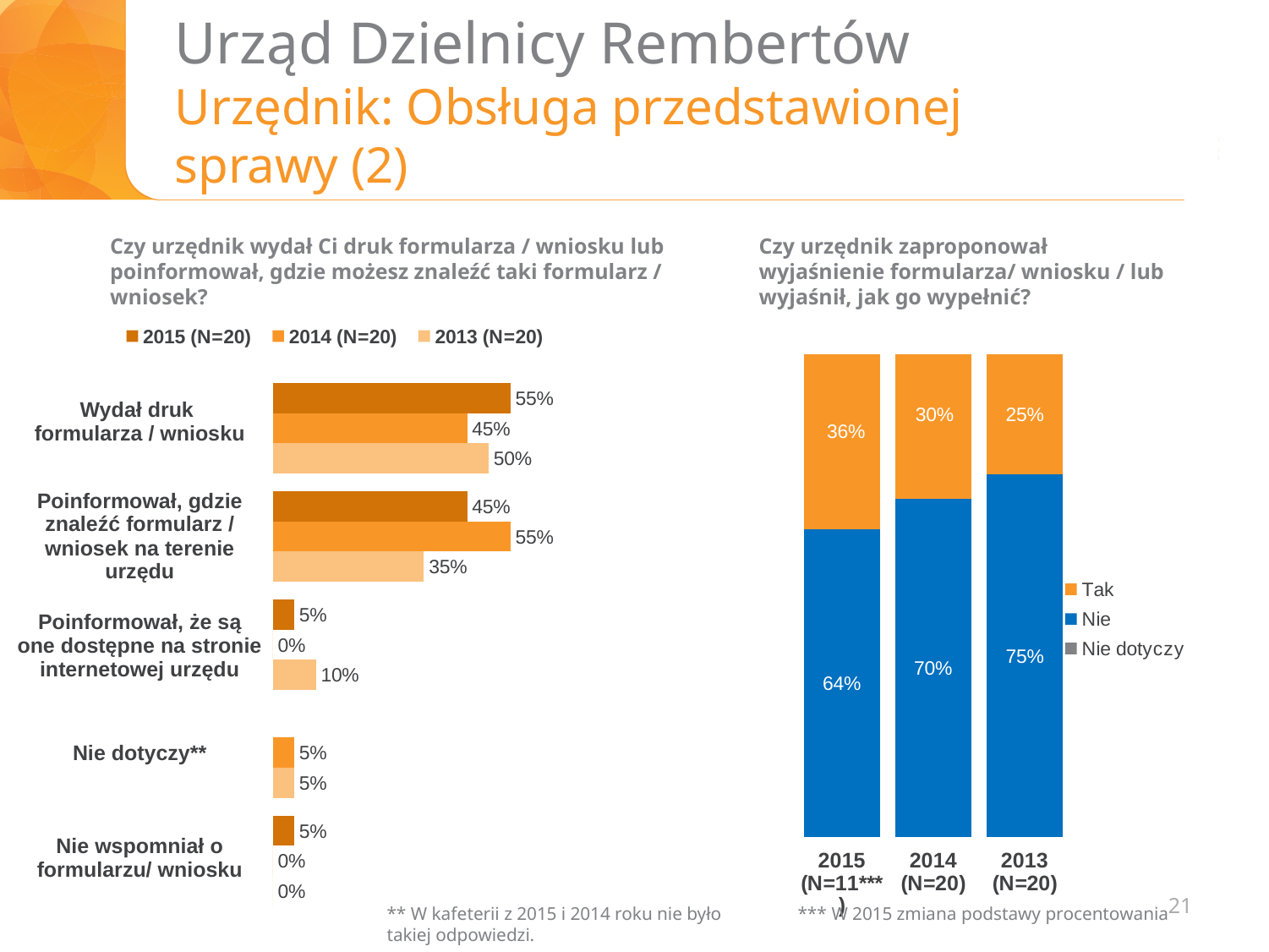
In the right chart, what is the "Tak" share for 2015? 36% What type of chart is the left chart? Bar chart In the right chart, is the "Tak" share for 2014 larger or smaller than for 2013? Larger In the left chart, which year has the highest value for "Poinformował, gdzie znaleźć formularz / wniosek na terenie urzędu"? 2014 (N=20) In the left chart, what is the 2013 value for "Poinformował, gdzie znaleźć formularz / wniosek na terenie urzędu"? 35% In the right chart, which year has the highest "Nie" share? 2013 (N=20) In the left chart, how many series does the legend list? 3 In the left chart, what is the difference between the 2015 and 2014 values for "Wydał druk formularza / wniosku"? 10% In the right chart, what is the "Nie" share for 2013? 75% In the left chart, what is the 2015 value for "Wydał druk formularza / wniosku"? 55% In the right chart, how many entries does the legend list? 3 In the left chart, what is the 2013 value for "Poinformował, że są one dostępne na stronie internetowej urzędu"? 10%